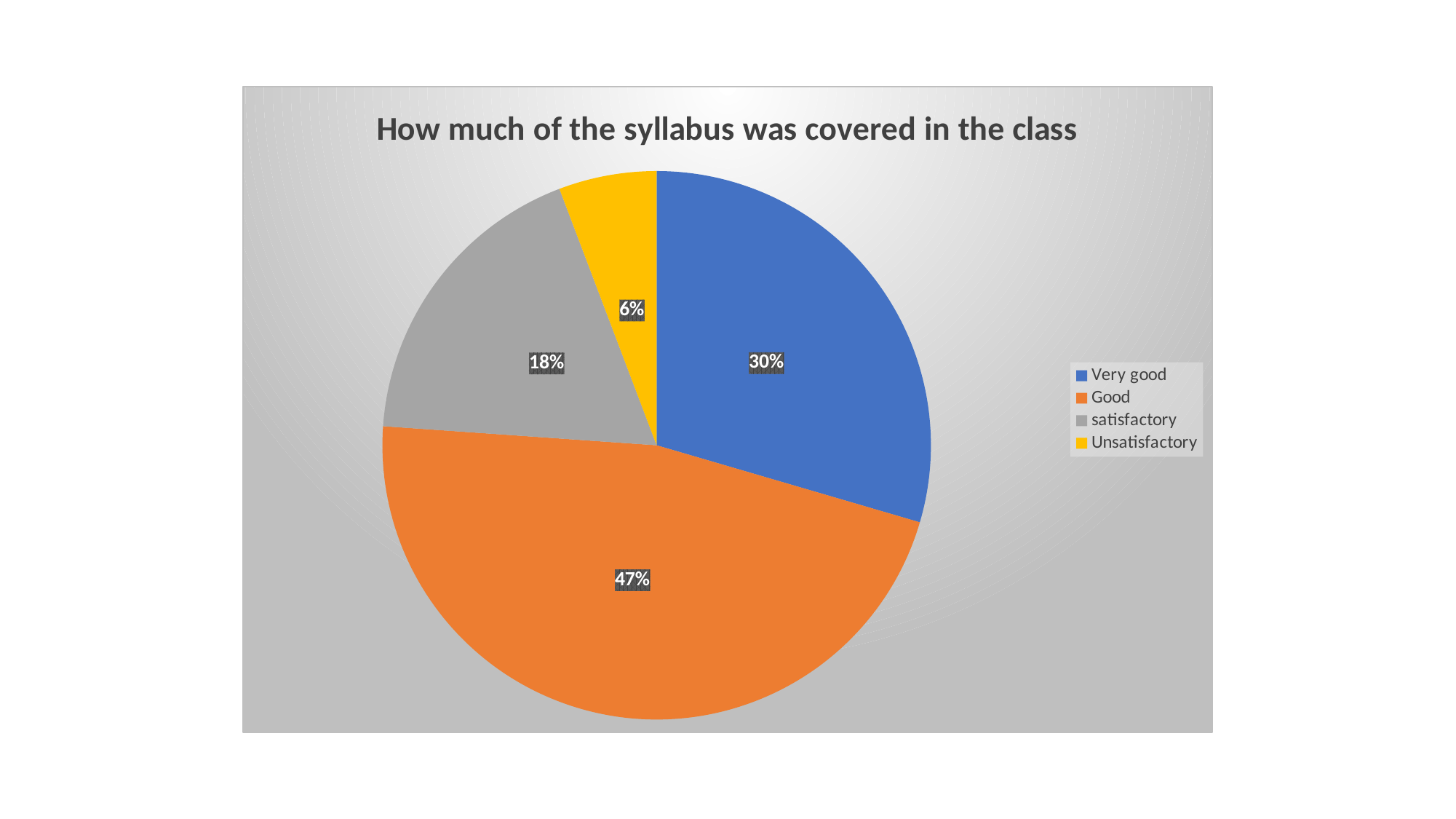
Which category has the largest slice of the pie? Good Which category has the smallest slice of the pie? Unsatisfactory How many entries does the legend list? 4 Which slice is larger, satisfactory or Unsatisfactory? satisfactory What share of the pie is labelled Good? 47% What is the difference in percentage points between the Good and Very good slices? 17 What kind of chart is shown on the slide? pie chart What share of the pie is labelled Unsatisfactory? 6% How many slices does the pie chart have? 4 What is the title of the chart? How much of the syllabus was covered in the class What share of the pie is labelled Very good? 30% What share of the pie is labelled satisfactory? 18%